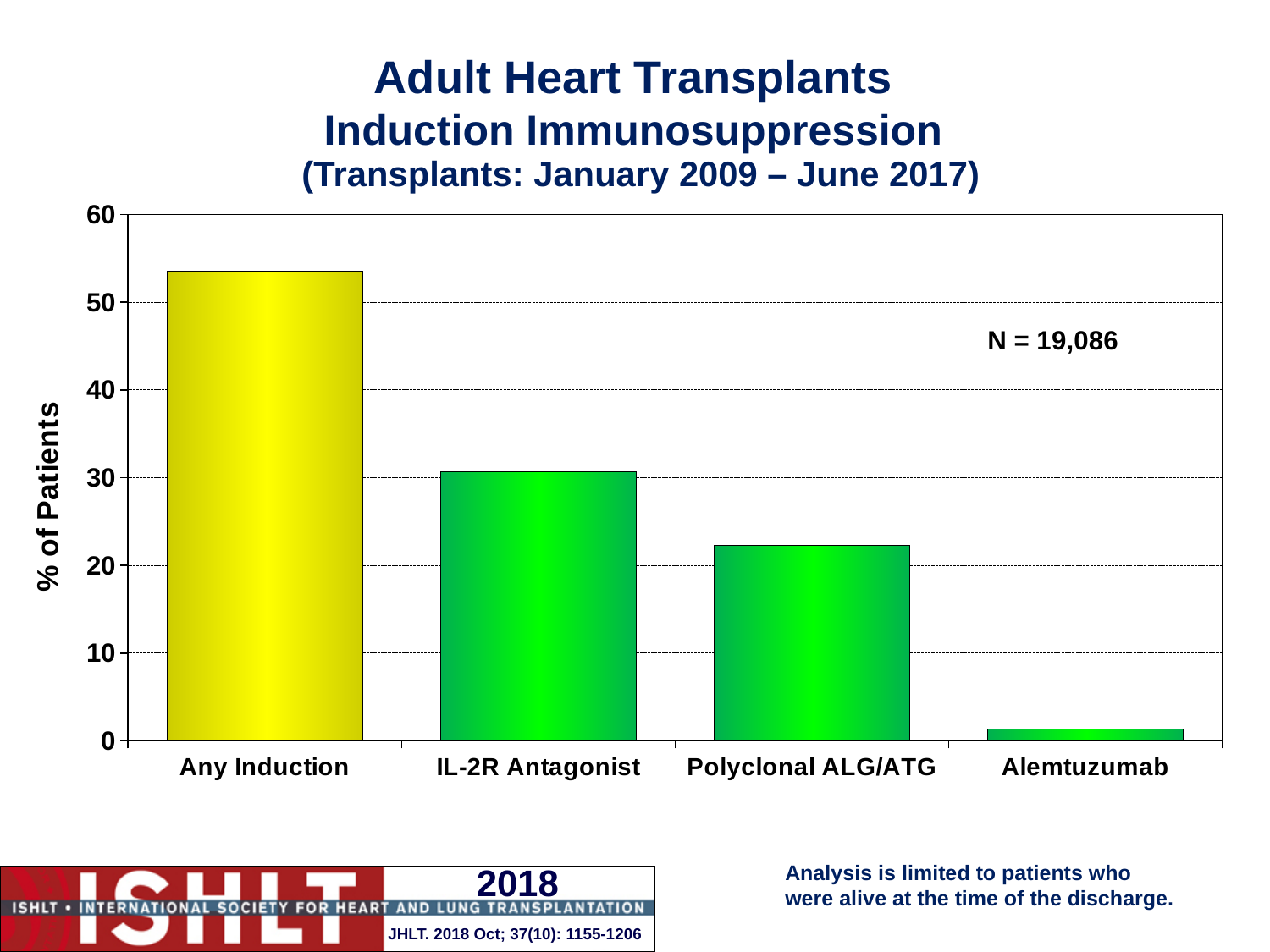
Which has a higher % of patients, Polyclonal ALG/ATG or Alemtuzumab? Polyclonal ALG/ATG What kind of chart is shown on the slide? bar chart What is the N value shown on the chart? N = 19,086 How many categories are shown on the x axis of the chart? 4 Do the bar values rise or fall from left to right along the x axis? fall Is the value for Alemtuzumab greater or less than 10? less Is the value for Any Induction greater or less than 50? greater Is the value for IL-2R Antagonist greater or less than 40? less Which category has the lowest % of patients? Alemtuzumab Which has a higher % of patients, IL-2R Antagonist or Polyclonal ALG/ATG? IL-2R Antagonist Which category has the highest % of patients? Any Induction